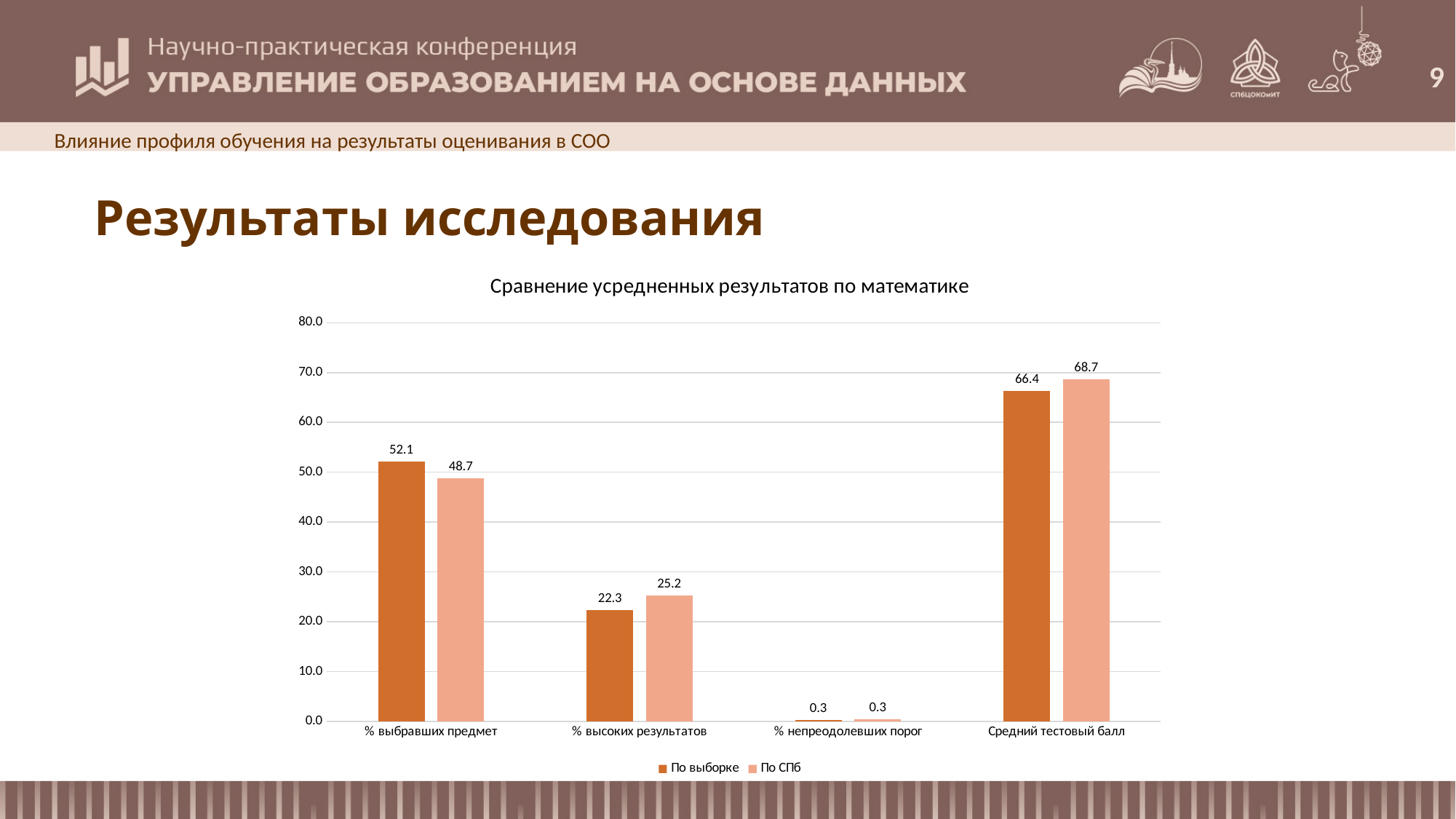
How many series does the legend list? 2 Which category has the lowest value for the "По СПб" series? % непреодолевших порог Is the value for "По выборке" in the "% выбравших предмет" category greater or less than 50.0? greater What is the value for "По СПб" in the "Средний тестовый балл" category? 68.7 What is the difference between "По СПб" and "По выборке" in the "Средний тестовый балл" category? 2.3 How many categories are shown on the x axis? 4 What is the difference between "По выборке" and "По СПб" in the "% выбравших предмет" category? 3.4 What is the value for "По выборке" in the "% выбравших предмет" category? 52.1 What type of chart is shown on the slide? Bar chart In the "% высоких результатов" category, which series has the larger value, "По выборке" or "По СПб"? По СПб What is the value for "По СПб" in the "% высоких результатов" category? 25.2 Which category has the highest value for the "По выборке" series? Средний тестовый балл